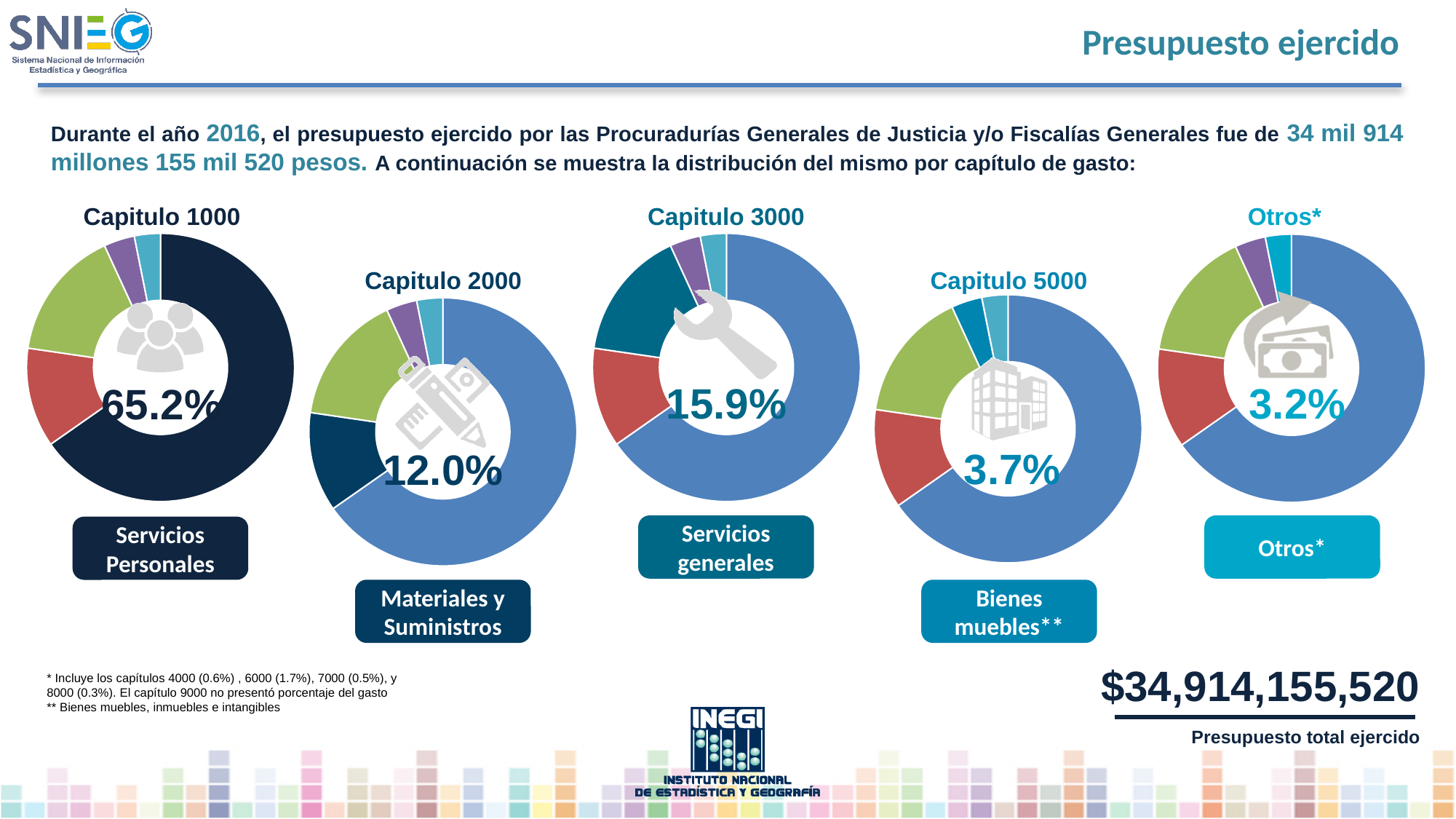
Which chapter (capítulo) has the highest percentage shown among the five donut charts? Capitulo 1000 How many donut charts are shown on the slide? 5 What percentage is shown in the centre of the Capitulo 5000 donut chart? 3.7% What percentage is shown in the centre of the Otros* donut chart? 3.2% Which has a larger percentage, Capitulo 2000 or Capitulo 3000? Capitulo 3000 What percentage is shown in the centre of the Capitulo 1000 donut chart? 65.2% What kind of chart is used to show the Capitulo 3000 share? Donut (pie) chart What percentage is shown in the centre of the Capitulo 2000 donut chart? 12.0% What is the difference in percentage points between the Capitulo 1000 value and the Capitulo 2000 value? 53.2 Which of the five donut charts shows the lowest percentage? Otros* What is the difference in percentage points between the Capitulo 5000 value and the Otros* value? 0.5 What percentage is shown in the centre of the Capitulo 3000 donut chart? 15.9%